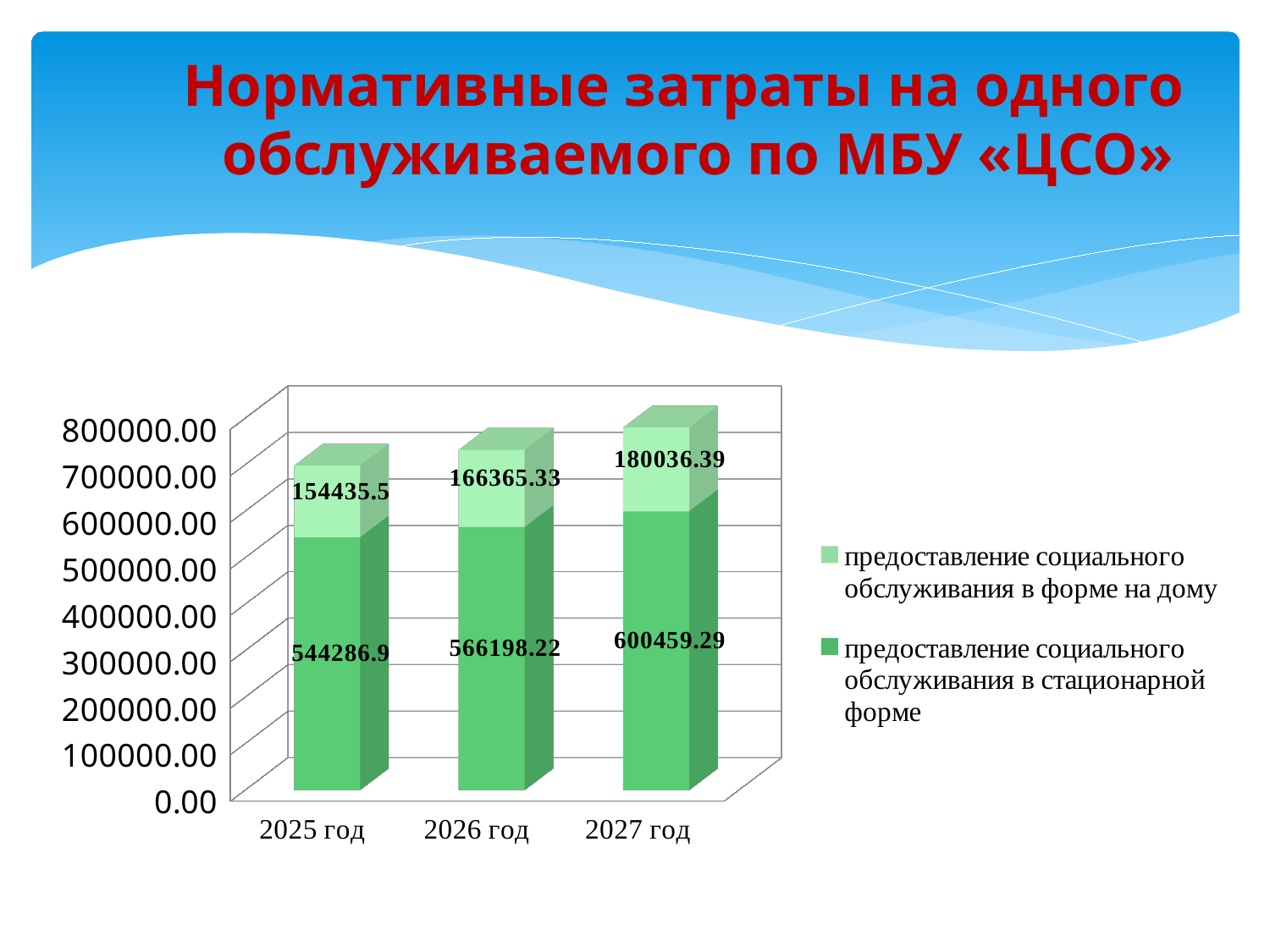
What type of chart is shown on the slide? Stacked bar chart What is the value for «предоставление социального обслуживания в форме на дому» in 2026 год? 166365.33 How many years (categories) are shown on the x axis? 3 Which series is shown in the darker green colour? предоставление социального обслуживания в стационарной форме Do the values for «предоставление социального обслуживания в стационарной форме» rise or fall from 2025 год to 2027 год? Rise In which year is the value for «предоставление социального обслуживания в форме на дому» lowest? 2025 год What is the value for «предоставление социального обслуживания в стационарной форме» in 2025 год? 544286.9 What is the total of the stacked bar for 2026 год? 732563.55 What is the value for «предоставление социального обслуживания в форме на дому» in 2027 год? 180036.39 What is the difference between the «стационарной форме» values for 2027 год and 2025 год? 56172.39 How many series does the legend list? 2 In which year is the value for «предоставление социального обслуживания в стационарной форме» highest? 2027 год